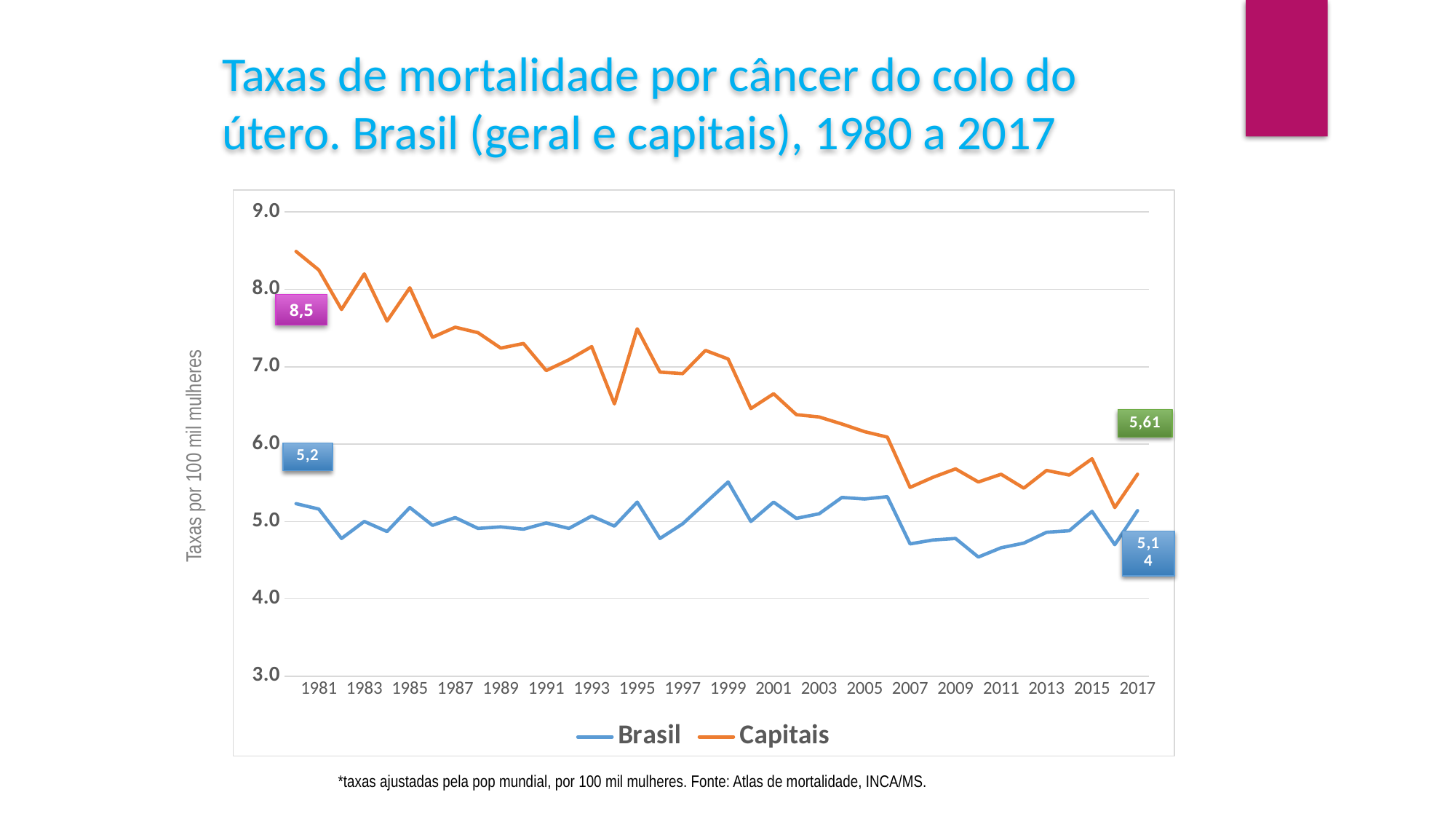
Is the value for Capitais in 2007 greater or less than 6.0? less What is the difference between the Capitais and Brasil values in 1980? 3,3 What is the labelled value for Capitais in 1980? 8,5 What is the labelled value for Capitais in 2017? 5,61 How many series does the legend list? 2 Does the Capitais series generally rise or fall from 1980 to 2017? fall What are the two series named in the legend? Brasil and Capitais Which series has the higher value in 2017, Brasil or Capitais? Capitais What is the labelled value for Brasil in 2017? 5,14 What is the labelled value for Brasil in 1980? 5,2 What kind of chart is shown on the slide? line chart By how much did the Capitais rate fall from 1980 to 2017? 2,89